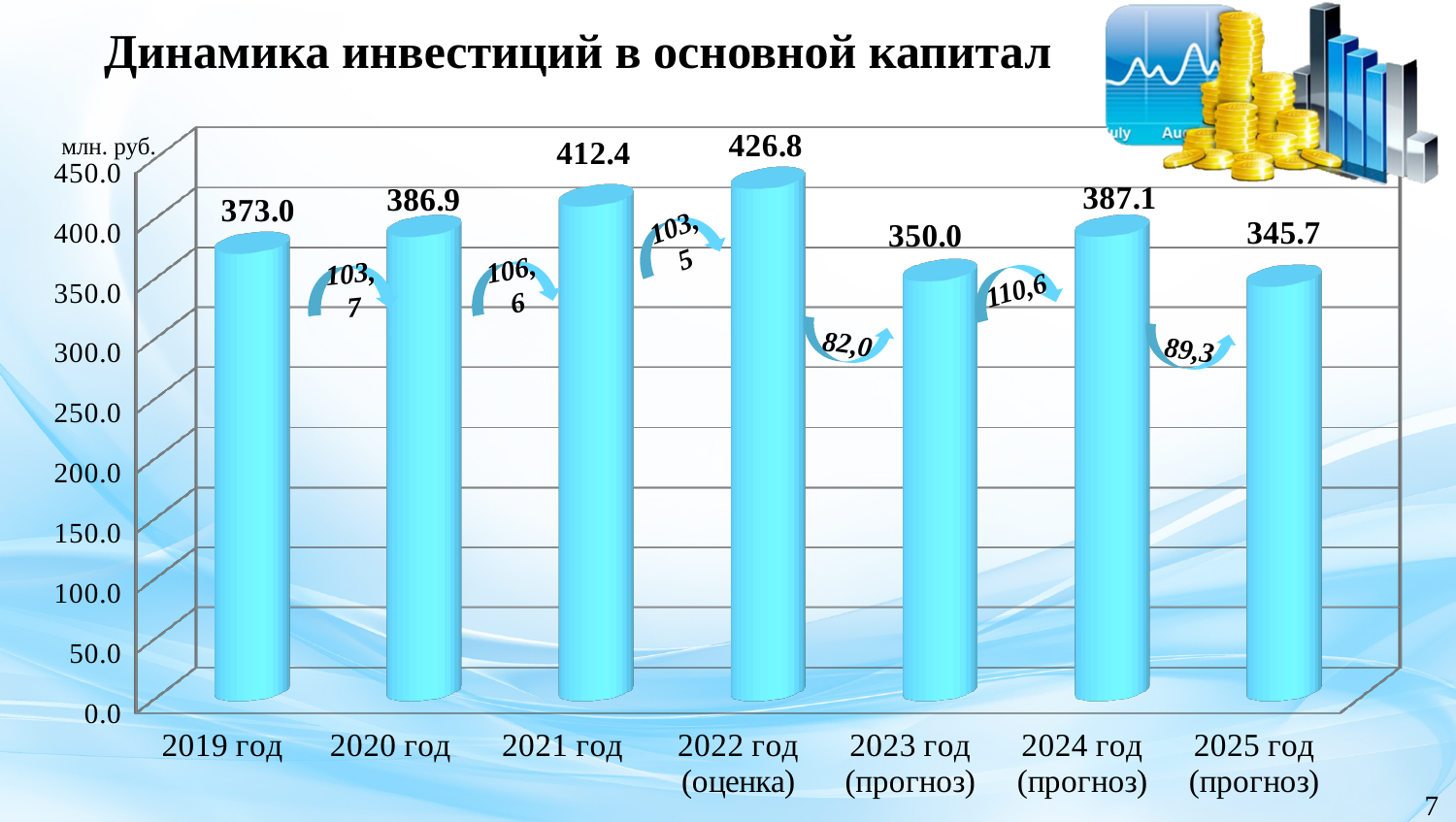
Which year has the highest value? 2022 год (оценка) Which year has the lowest value? 2025 год (прогноз) What is the value for 2023 год (прогноз)? 350.0 What is the difference between the values for 2022 год (оценка) and 2023 год (прогноз)? 76.8 What is the value for 2019 год? 373.0 What kind of chart is shown on the slide? bar chart Which is larger, the value for 2020 год or the value for 2024 год (прогноз)? 2024 год (прогноз) What is the title of the chart? Динамика инвестиций в основной капитал What is the value for 2021 год? 412.4 Is the value for 2021 год greater or less than 400.0? greater What unit is shown on the y axis? млн. руб. How many years are shown on the x axis? 7